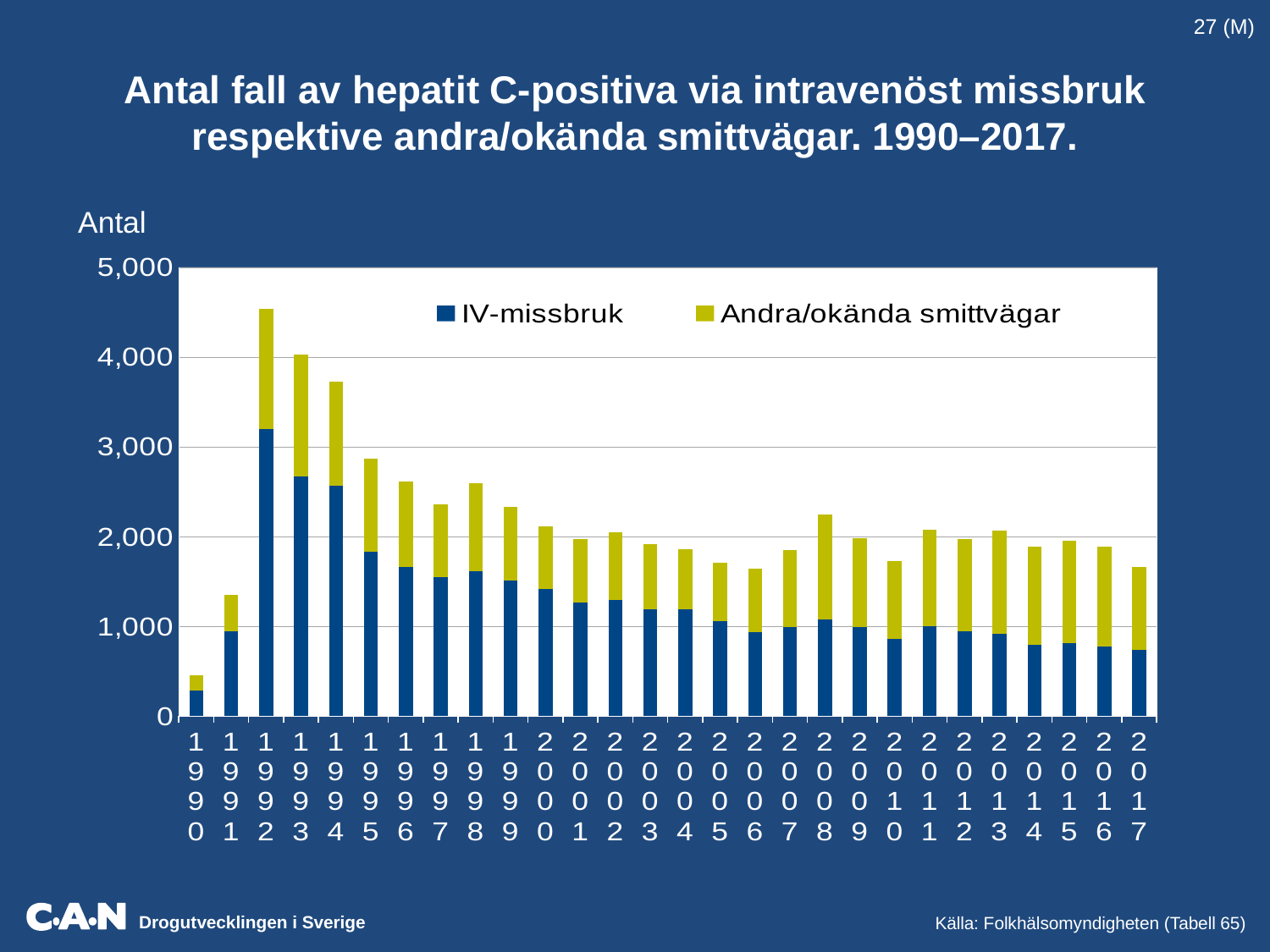
What kind of chart is shown on the slide? Stacked bar chart Does the IV-missbruk series generally rise or fall from 1992 to 2017? fall Which year has the larger total, 1992 or 1993? 1992 Is the total for 1990 greater or less than 1,000? less What is the label on the vertical axis? Antal Which year has the highest value for IV-missbruk? 1992 Is the IV-missbruk value for 2017 greater or less than 1,000? less How many series does the legend list? 2 Which year has the lowest total number of cases? 1990 Which year has the highest total number of cases? 1992 How many years are shown along the x axis? 28 Is the total for 1992 greater or less than 4,000? greater